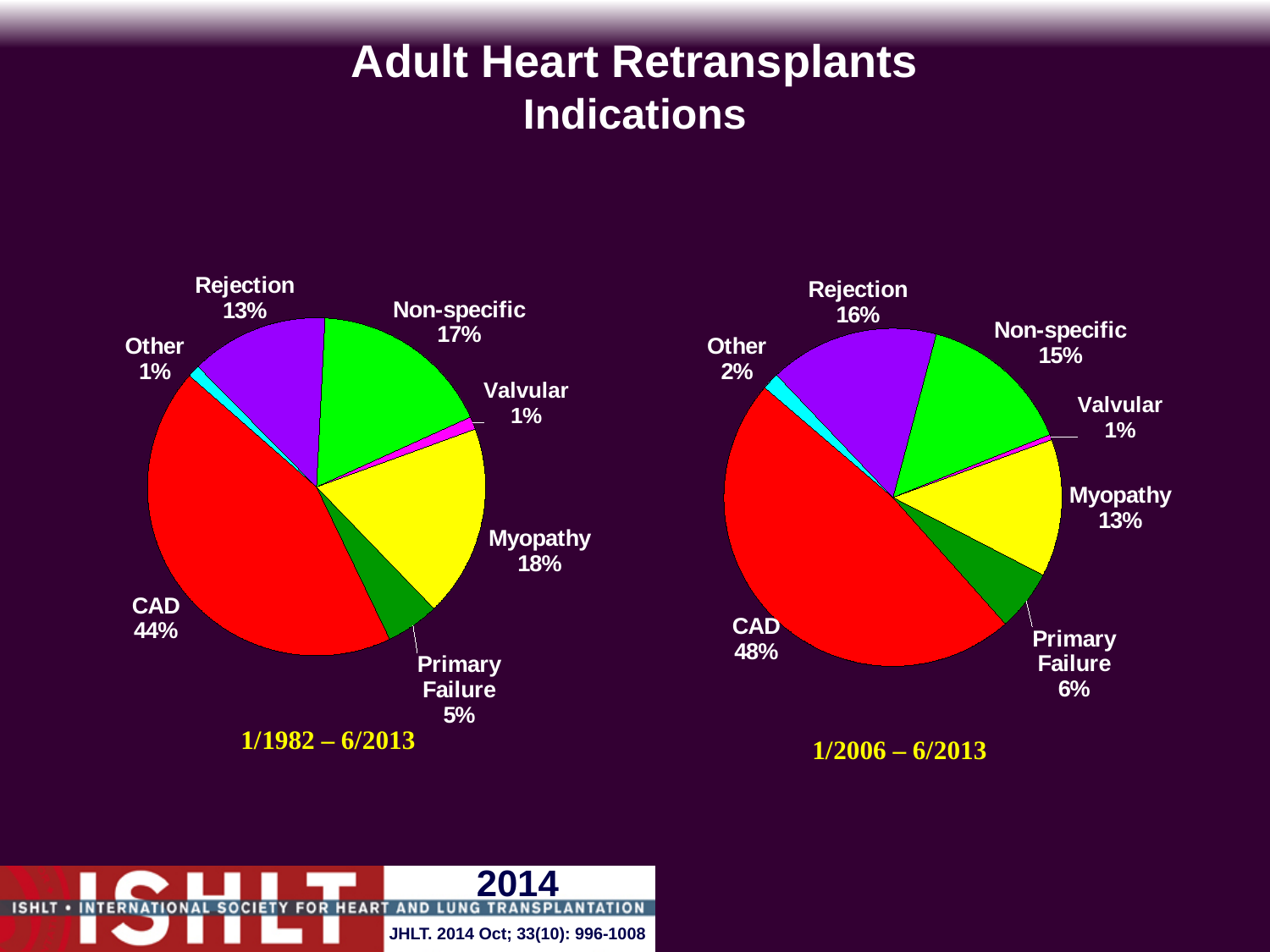
How many slices does the 1/2006 – 6/2013 pie chart have? 7 In the 1/2006 – 6/2013 pie chart, what share is Rejection? 16% In the 1/1982 – 6/2013 pie chart, what share is Primary Failure? 5% In the 1/1982 – 6/2013 pie chart, what share is Myopathy? 18% In the 1/2006 – 6/2013 pie chart, which indication has the smallest share? Valvular In the 1/2006 – 6/2013 pie chart, which is larger, Non-specific or Myopathy? Non-specific What type of chart is used on the left side of the slide? Pie chart In the 1/1982 – 6/2013 pie chart, what share is CAD? 44% In the 1/2006 – 6/2013 pie chart, what share is CAD? 48% In the 1/1982 – 6/2013 pie chart, what is the difference between the Non-specific and Rejection shares? 4% What colour is the CAD slice in both pie charts? Red In the 1/1982 – 6/2013 pie chart, which indication has the largest share? CAD